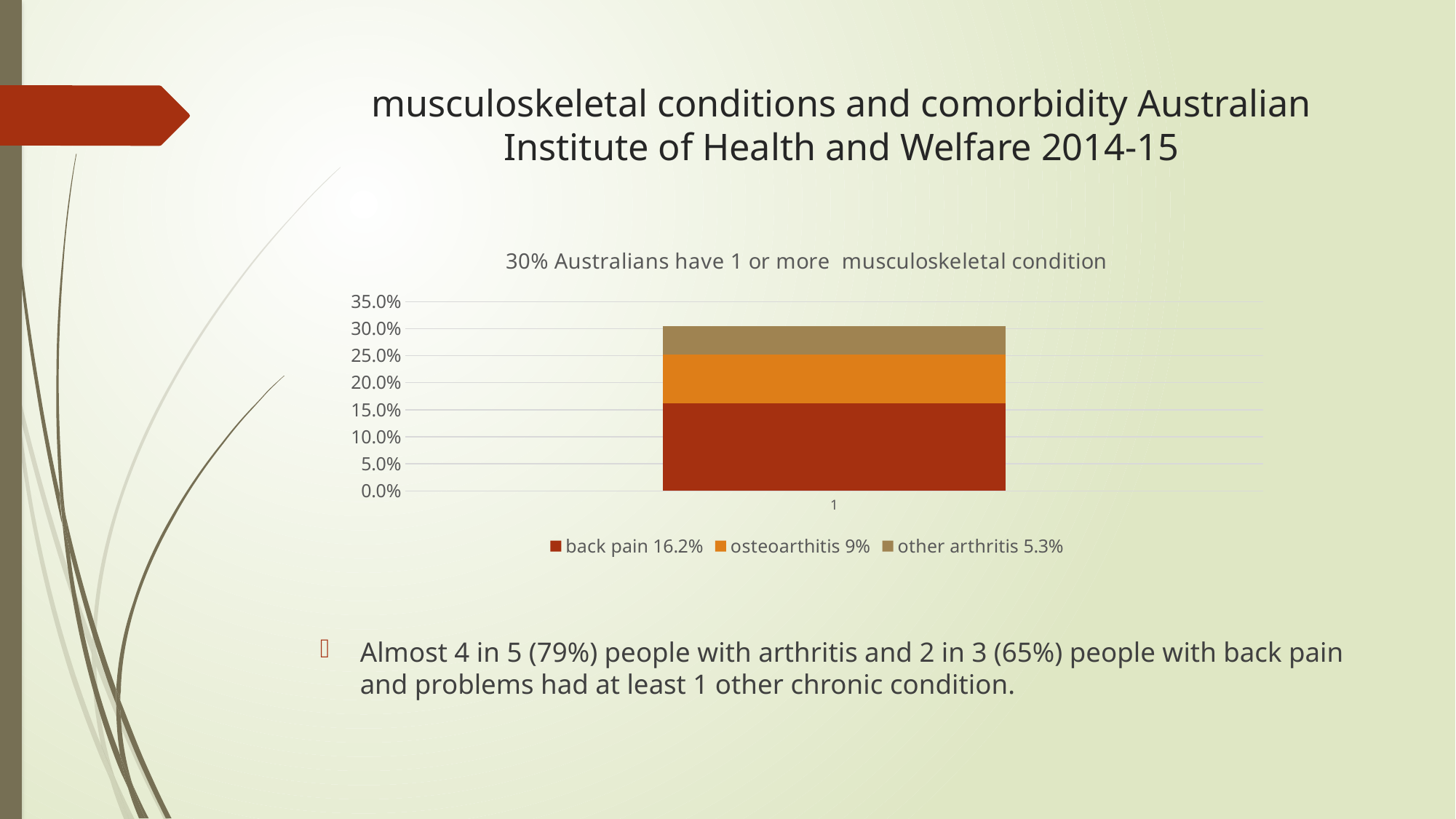
What is the total of the stacked bar, summing the three legend values? 30.5% What is the chart's title? 30% Australians have 1 or more musculoskeletal condition What value does the legend give for osteoarthitis? 9% What kind of chart is shown on the slide? stacked bar chart How many series does the legend list? 3 Which series has the largest value? back pain What value does the legend give for other arthritis? 5.3% What value does the legend give for back pain? 16.2% Which is larger, the osteoarthitis value or the other arthritis value? osteoarthitis What is the difference between the back pain value and the osteoarthitis value? 7.2% Which series has the smallest value? other arthritis How many bars are plotted in the chart? 1